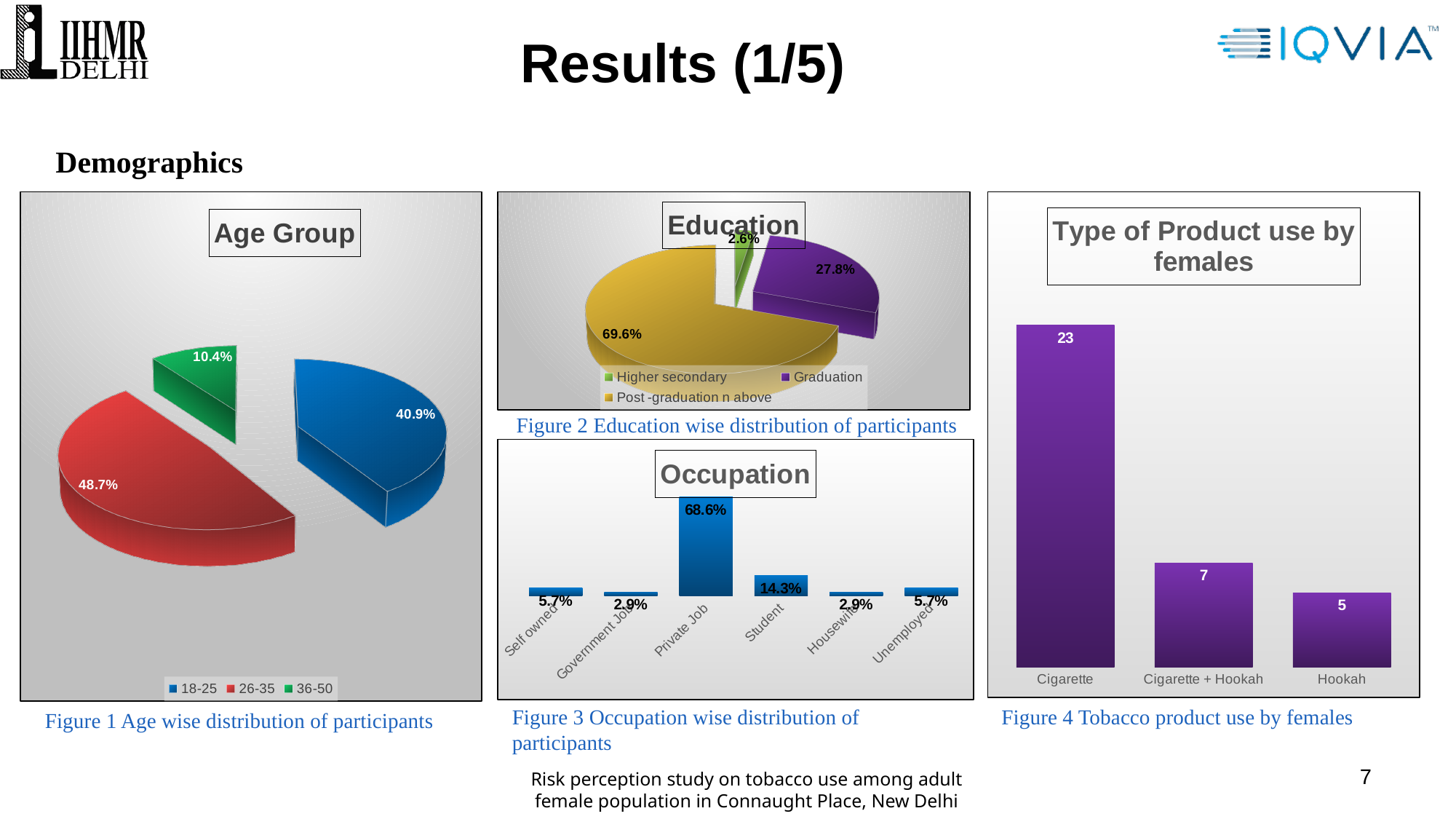
In the Occupation chart, which occupation has the highest value? Private Job In the Occupation chart, what is the value for Private Job? 68.6% In the Education chart, which category has the largest share? Post -graduation n above In the Type of Product use by females chart, what is the difference between Cigarette and Hookah? 18 In the Age Group chart, what is the difference between the 26-35 and 18-25 shares? 7.8% In the Age Group chart, what share of participants are aged 26-35? 48.7% How many categories does the Education chart's legend list? 3 In the Type of Product use by females chart, what is the value for Cigarette + Hookah? 7 How many occupation categories are shown in the Occupation chart? 6 In the Education chart, what share of participants have Post-graduation n above? 69.6% In the Age Group chart, which age group has the smallest share? 36-50 What kind of chart is the Education chart? Pie chart